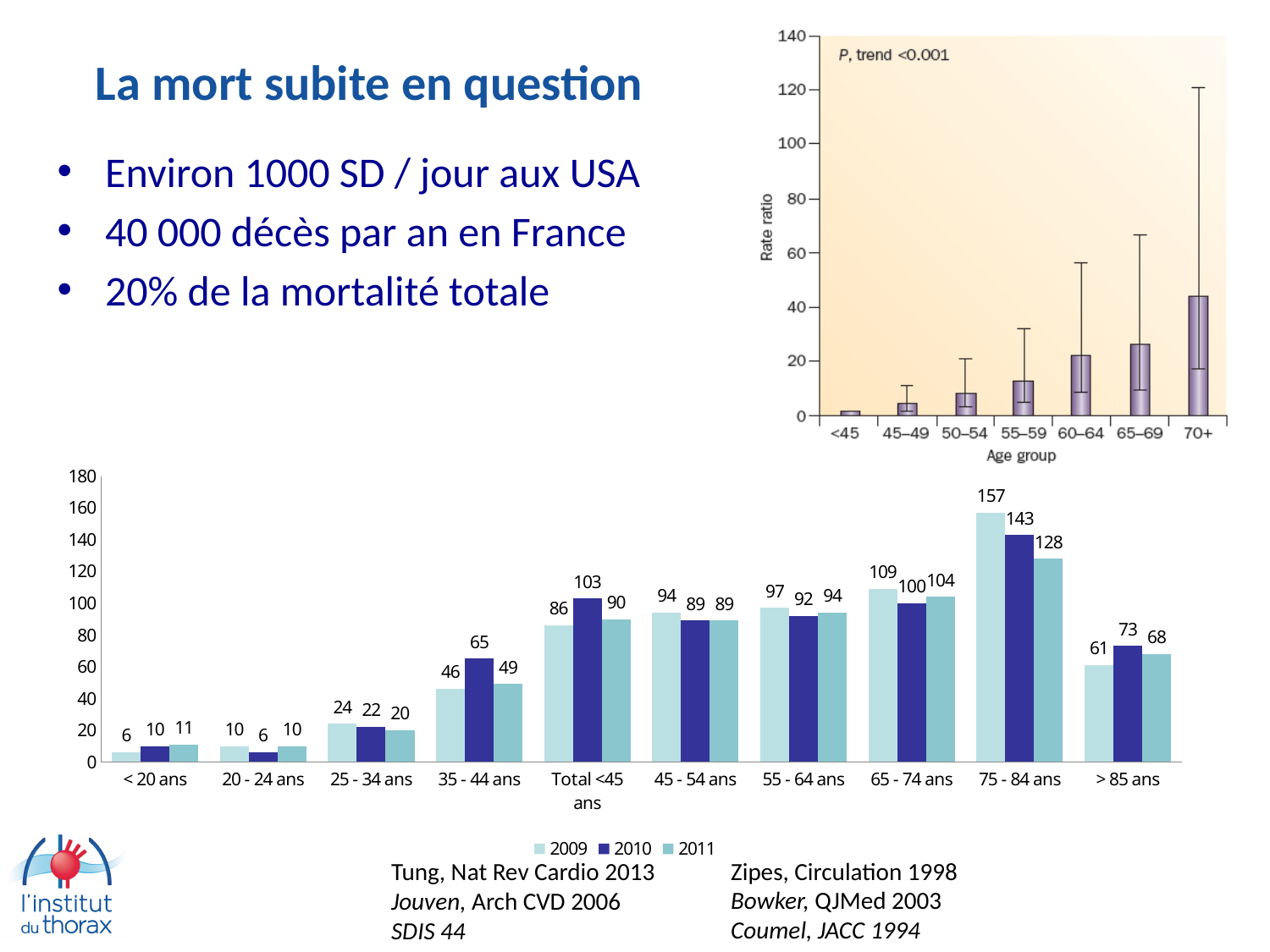
In the bottom bar chart, what is the value for 2010 in the 35 - 44 ans age group? 65 In the bottom bar chart, which is larger for the 65 - 74 ans age group: the 2009 value or the 2010 value? 2009 In the bottom bar chart, what is the difference between the 2009 and 2011 values for the 75 - 84 ans age group? 29 What kind of chart is the chart in the top right of the slide (Rate ratio by Age group)? bar chart In the top-right chart (Rate ratio by Age group), is the value for the 70+ age group greater or less than 40? greater In the bottom bar chart, which age group has the highest value for 2011? 75 - 84 ans How many series does the legend of the bottom bar chart list? 3 In the bottom bar chart, what is the value for 2009 in the 75 - 84 ans age group? 157 How many age-group categories are shown on the x axis of the bottom bar chart? 10 In the bottom bar chart, which age group has the lowest value for 2009? < 20 ans In the top-right chart (Rate ratio by Age group), do the rate ratio values rise or fall as the age group increases along the x axis? rise In the bottom bar chart, what is the value for 2011 in the Total <45 ans category? 90